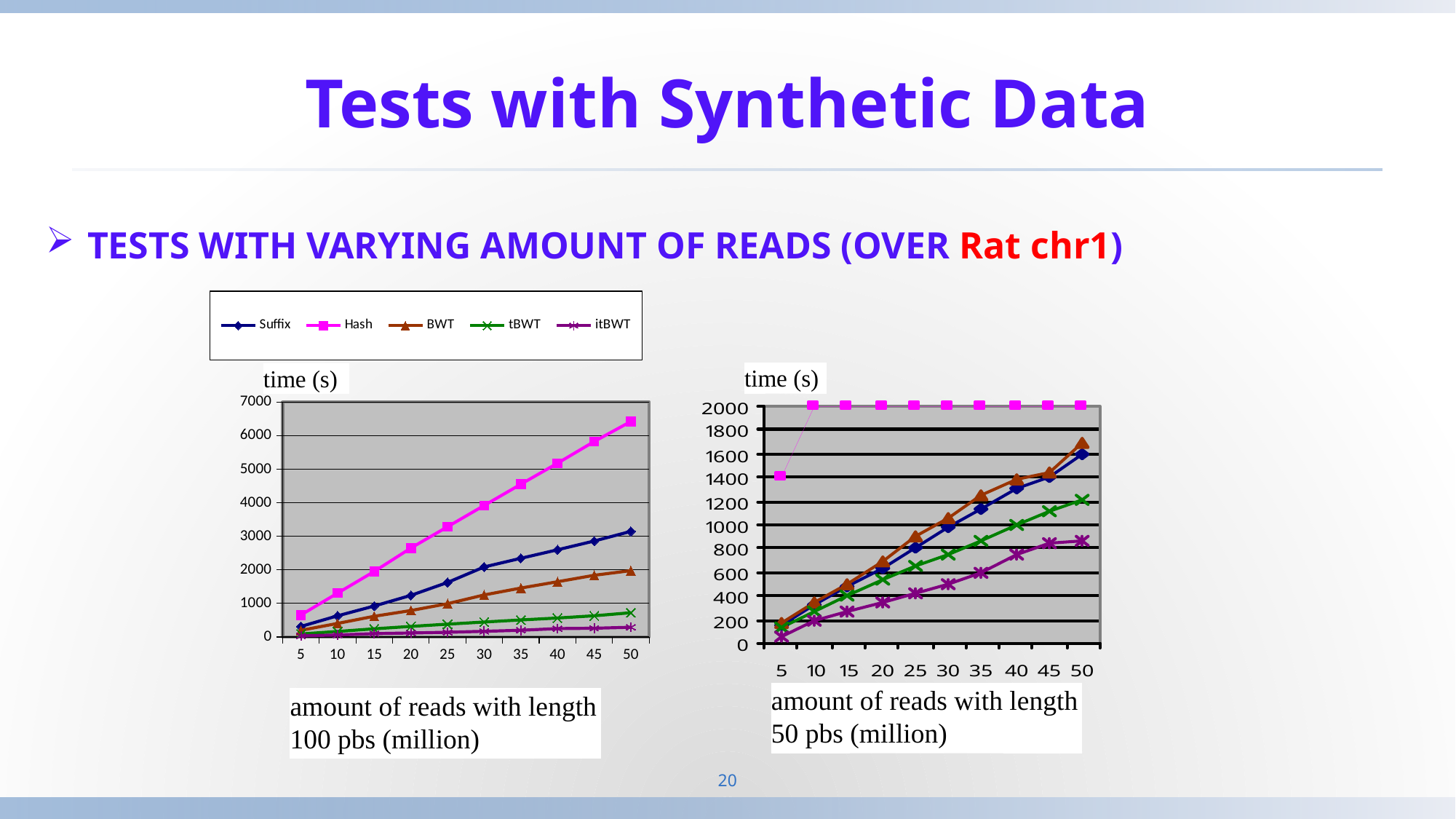
In the right chart (reads with length 50 pbs), which series has the lowest time at 50 million reads? itBWT What kind of chart is the left chart (reads with length 100 pbs)? line chart In the left chart (reads with length 100 pbs), is the tBWT value at 50 million reads greater or less than 1000? less In the left chart (reads with length 100 pbs), which series has the highest time at 50 million reads? Hash In the right chart (reads with length 50 pbs), is the itBWT value at 50 million reads greater or less than 1000? less In the left chart (reads with length 100 pbs), is the Hash value at 50 million reads greater or less than 6000? greater In the left chart (reads with length 100 pbs), does the Hash time rise or fall as the amount of reads increases? rise In the right chart (reads with length 50 pbs), which is larger at 50 million reads, BWT or tBWT? BWT In the left chart (reads with length 100 pbs), which series has the lowest time at 50 million reads? itBWT How many series does the legend list? 5 How many x-axis points are plotted in the left chart (reads with length 100 pbs)? 10